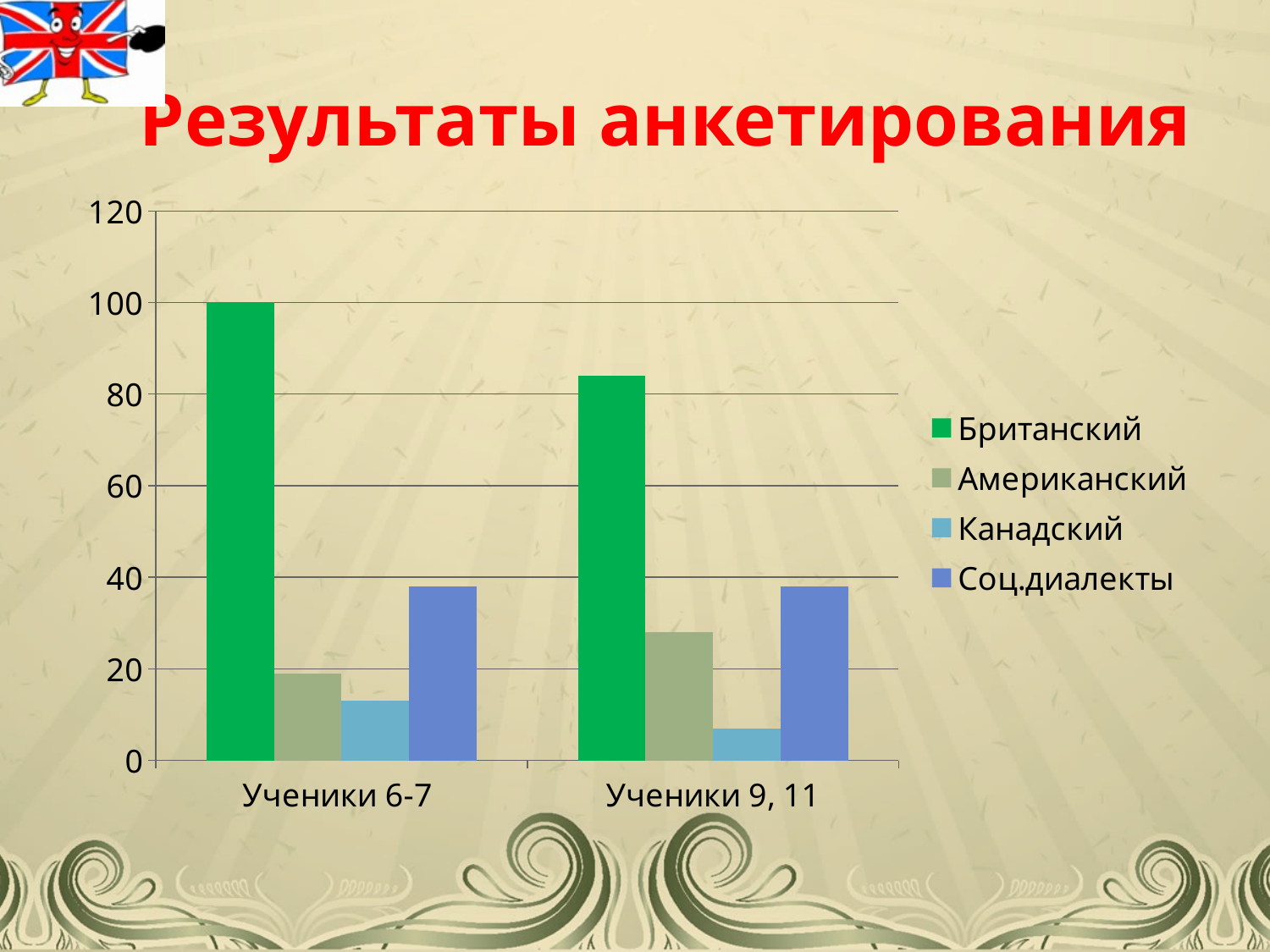
What kind of chart is shown on the slide? bar chart What is the value for Британский in the Ученики 6-7 category? 100 Is the value for Британский in the Ученики 9, 11 category greater or less than 80? greater Which series has the highest value in the Ученики 6-7 category? Британский Which series has the lowest value in the Ученики 9, 11 category? Канадский How many categories are shown on the x axis of the chart? 2 Which series has the highest value in the Ученики 9, 11 category? Британский How many series does the chart legend list? 4 Which series has the lowest value in the Ученики 6-7 category? Канадский What is the title of the slide containing the chart? Результаты анкетирования For the Американский series, which category has the larger value: Ученики 6-7 or Ученики 9, 11? Ученики 9, 11